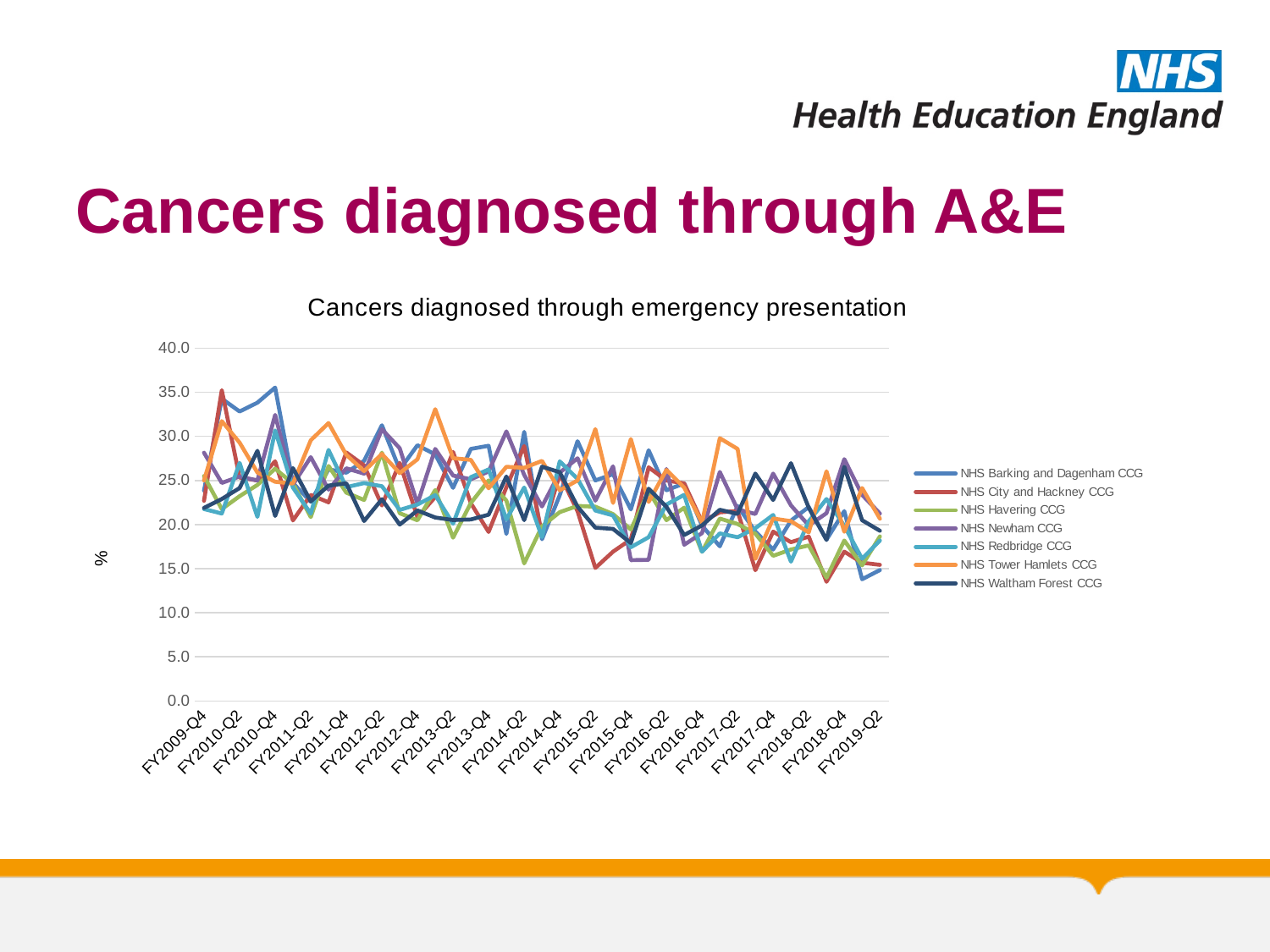
What is the first category label on the horizontal axis? FY2009-Q4 What is the label on the vertical axis of the chart? % Overall, do the values rise or fall from FY2009-Q4 to FY2019-Q2? Fall What is the highest value shown on the vertical axis? 40.0 How many series does the legend list? 7 Is the value for NHS Tower Hamlets CCG at FY2013-Q2 greater or less than 30.0? less Is the value for NHS Barking and Dagenham CCG at FY2010-Q4 greater or less than 30.0? greater Is the value for NHS Barking and Dagenham CCG at FY2019-Q2 greater or less than 20.0? less What kind of chart is shown on the slide? Line chart